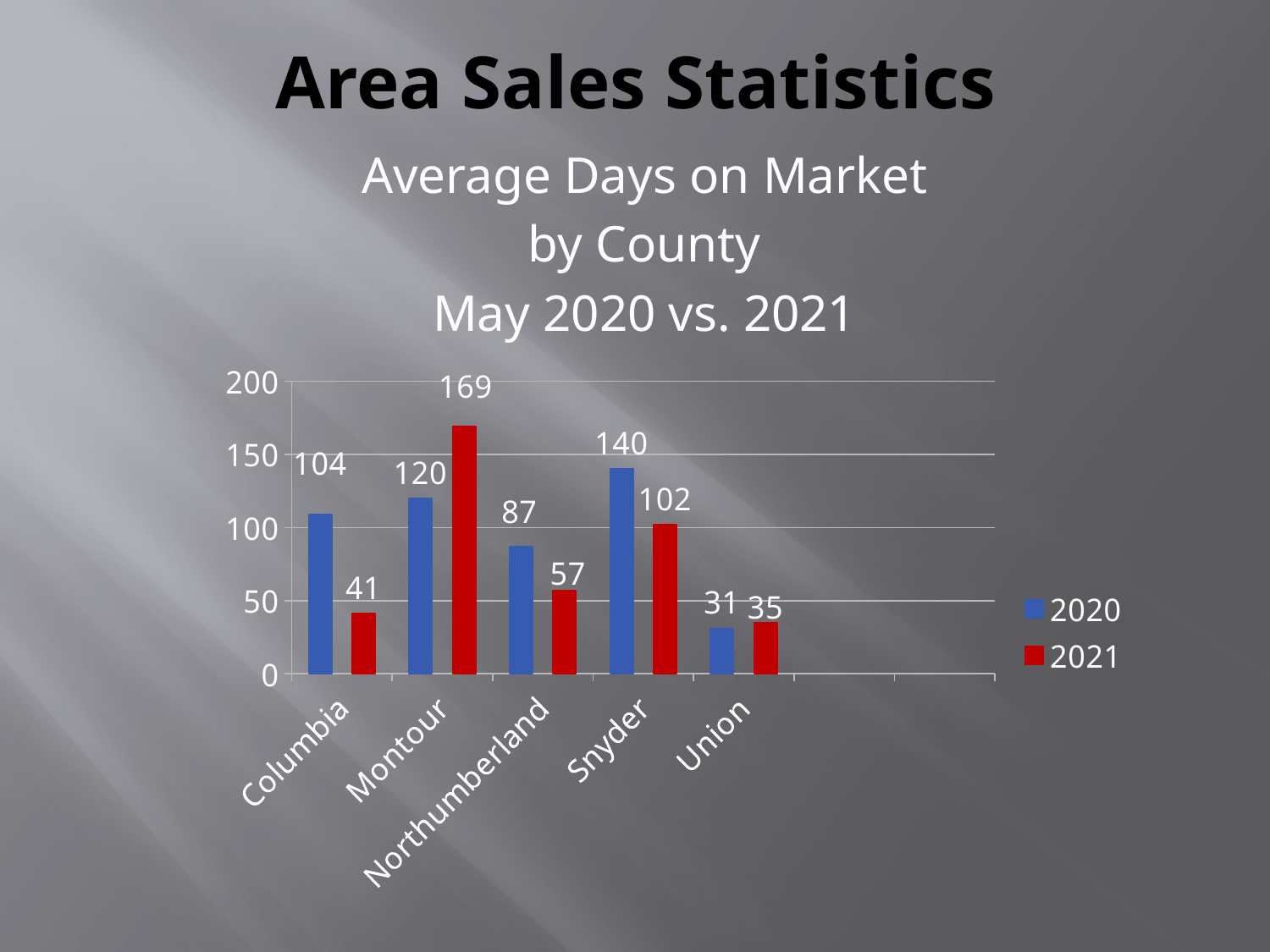
What was the average days on market for Montour in 2021? 169 Which county had the highest average days on market in 2021? Montour How many counties are shown on the x axis of the chart? 5 What was the average days on market for Union in 2020? 31 What is the difference between Snyder's 2020 and 2021 average days on market? 38 Which colour represents the 2021 series in the chart? Red What was the average days on market for Northumberland in 2021? 57 Which is larger, Columbia's 2020 value or Columbia's 2021 value? Columbia's 2020 value Which county had the lowest average days on market in 2020? Union How many series does the legend list? 2 What kind of chart is shown on the slide? Bar chart What was the average days on market for Columbia in 2020? 104